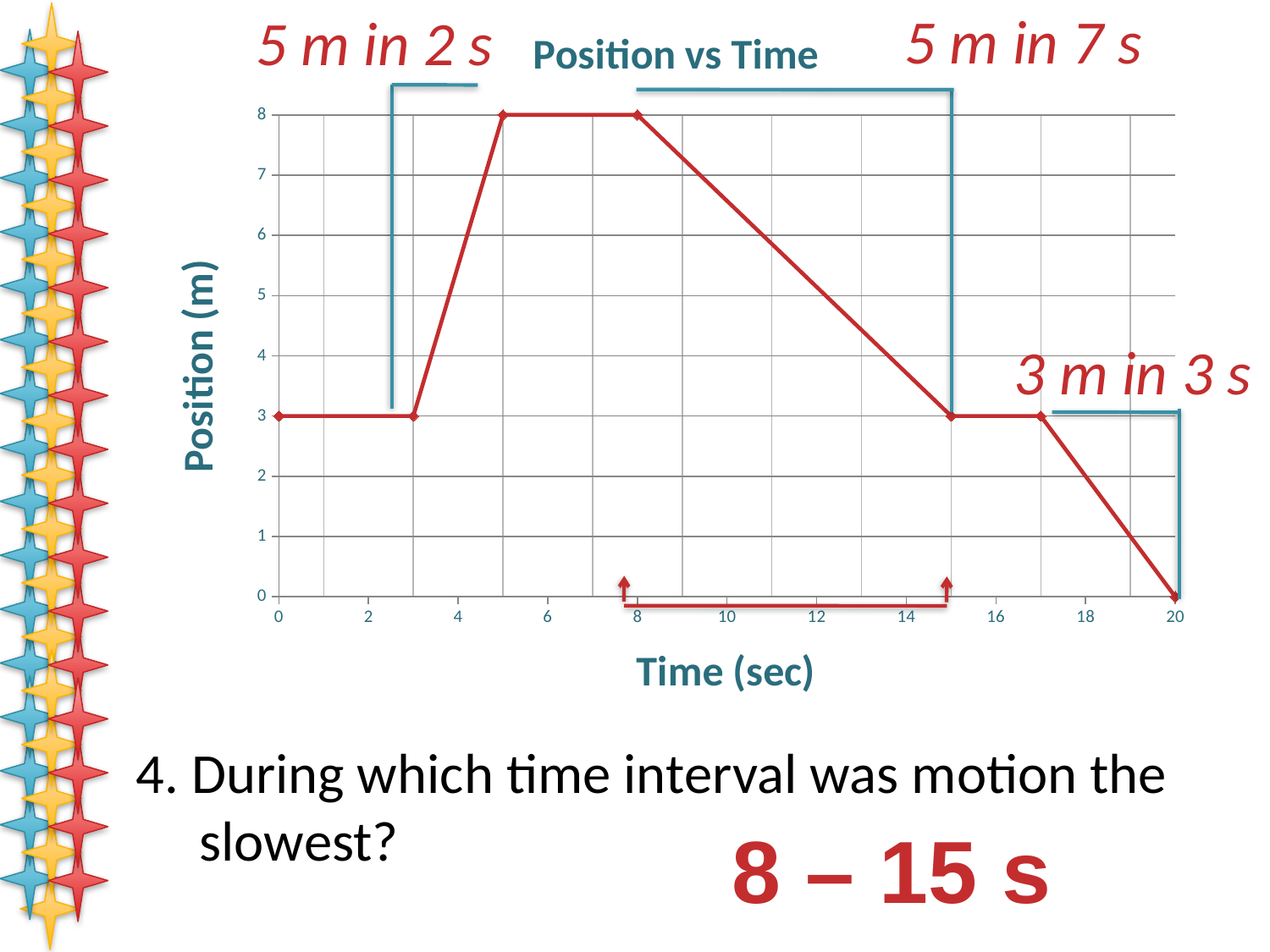
What is the lowest position value reached on the chart? 0 What is the title of the chart? Position vs Time How many data points are plotted on the line? 7 What kind of chart is shown on the slide? line chart Is the position at 14 s greater or less than 3? greater What is the position at time 0 s? 3 What is the highest position value reached on the chart? 8 Between 8 s and 15 s, does the position rise or fall? fall What is the position at time 8 s? 8 What is the position at time 20 s? 0 What is the label of the x axis of the chart? Time (sec) Between 0 s and 2 s, does the position rise, fall, or stay constant? stay constant